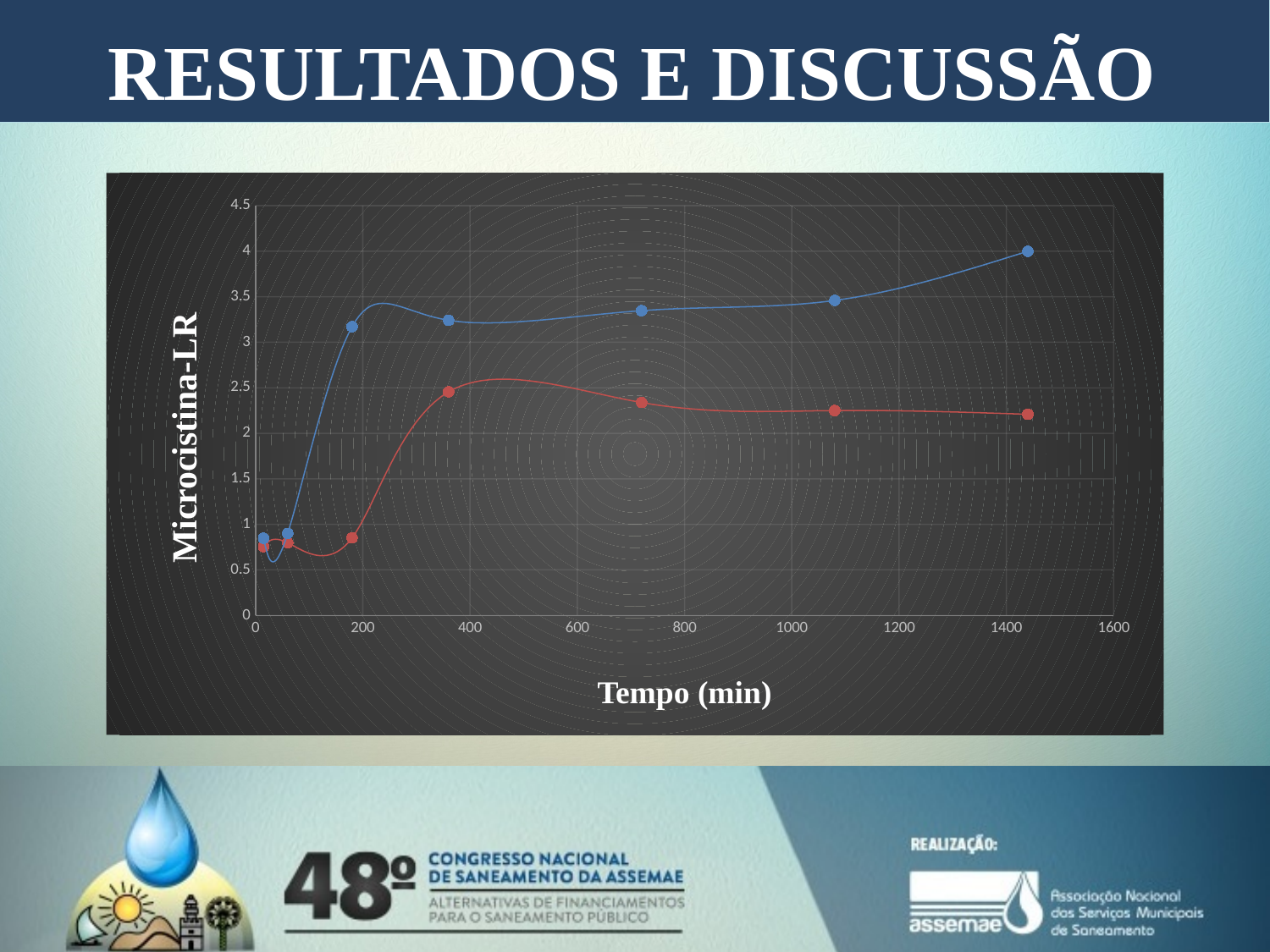
Is the value of the red series at about 360 min greater or less than 2? greater At which time (in min) does the blue series reach its highest value? 1440 How many data series are plotted on the chart? 2 Is the value of the blue series at about 60 min greater or less than 1? less Does the blue series overall rise or fall as time increases along the x axis? rise What is the title of the y axis of the chart? Microcistina-LR What kind of chart is shown on the slide? line chart What is the title of the x axis of the chart? Tempo (min) At 1440 min, which series has the higher value, the blue or the red? blue How many data points does the blue series have? 7 Is the value of the red series at 1440 min greater or less than 2.5? less